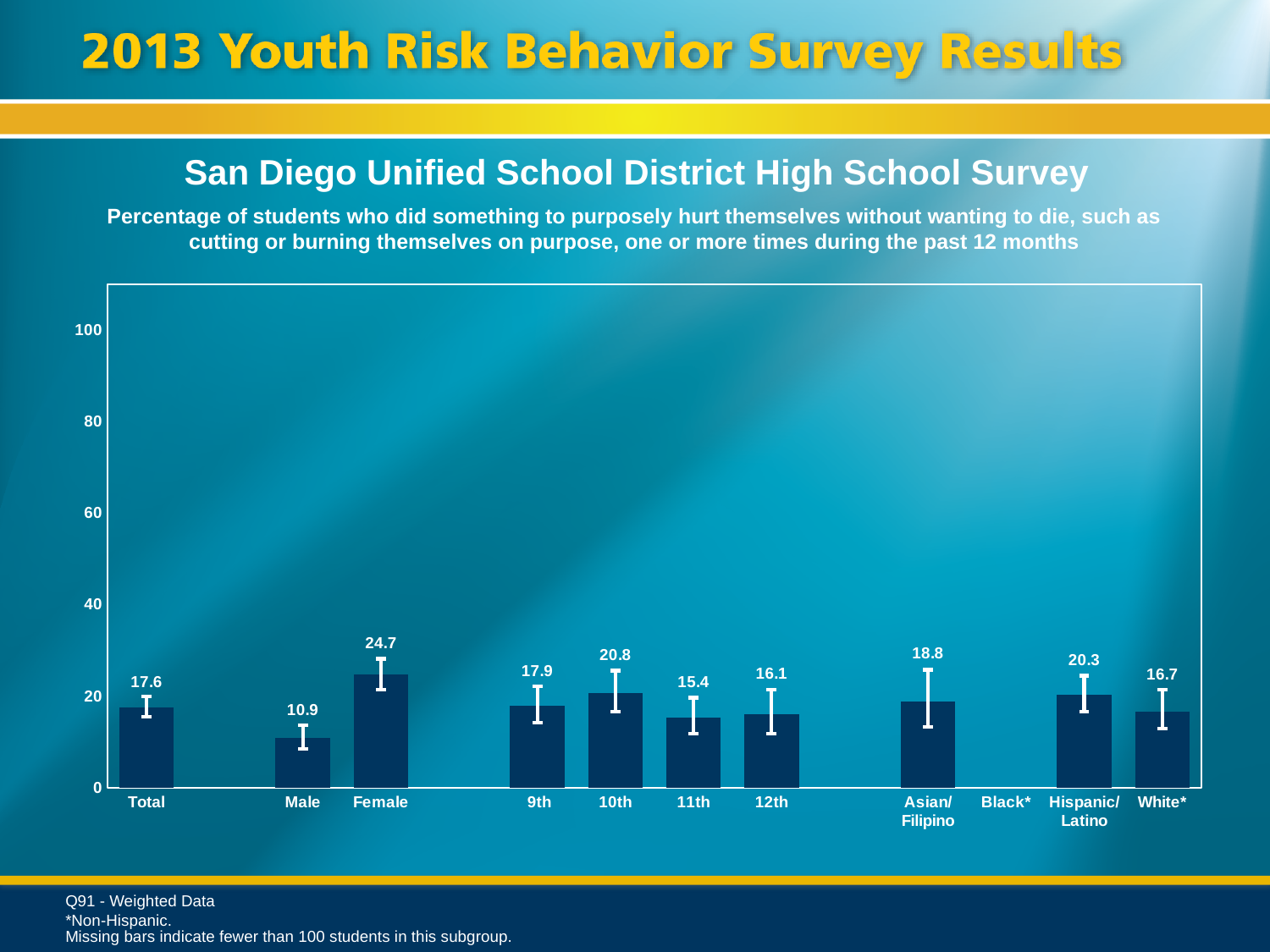
What kind of chart is shown? bar chart Is the value for Asian/Filipino greater or less than 20? less What is the value for Total? 17.6 What is the difference between the Female and Male values? 13.8 How many categories have a bar plotted? 11 What is the value for 11th grade? 15.4 What is the value for Hispanic/Latino? 20.3 Which category has the highest value? Female What is the value for Female? 24.7 Which category label has no bar plotted? Black* Which is larger, the value for 10th grade or 12th grade? 10th Which category has the lowest value? Male